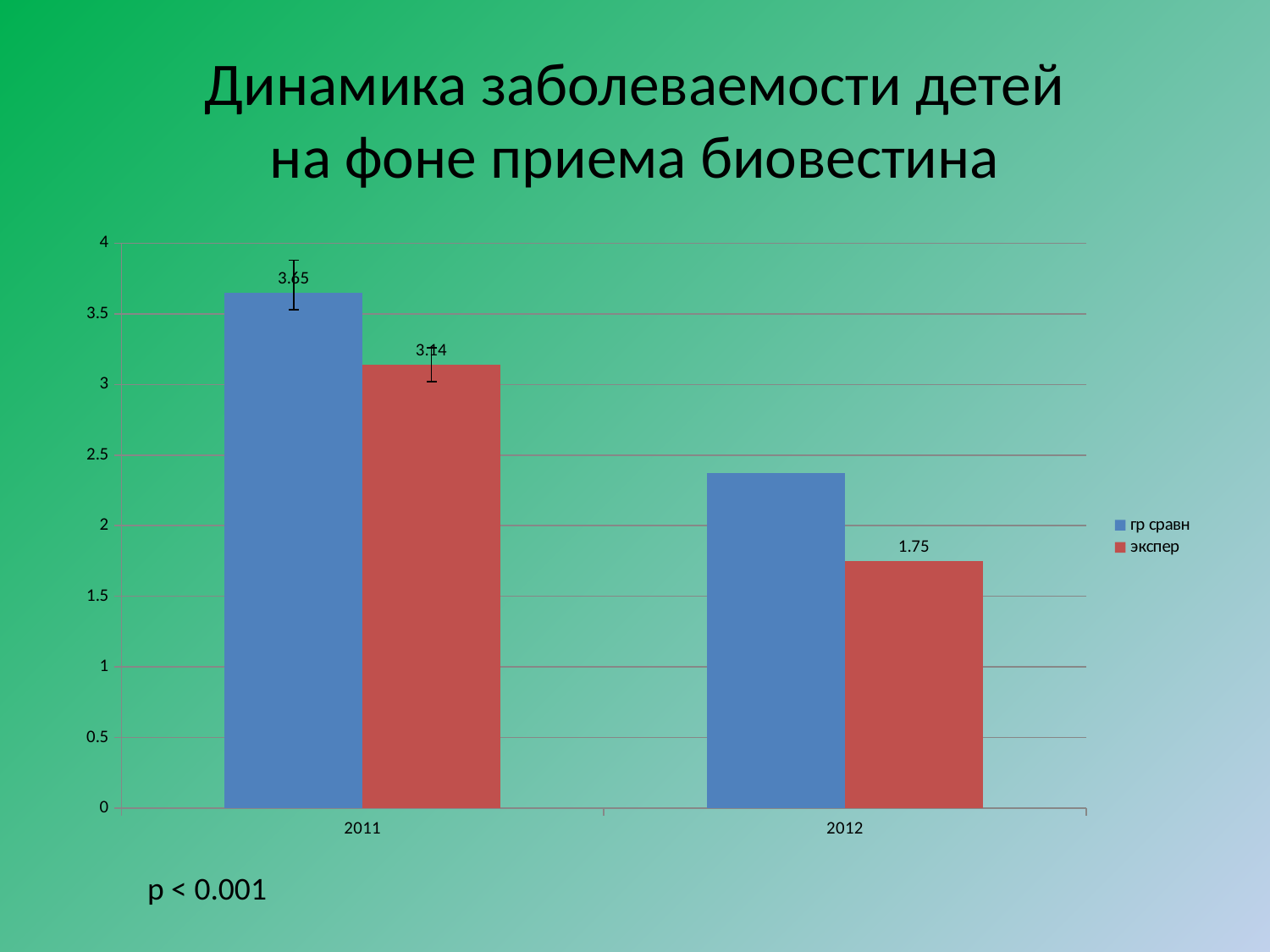
Is the value for гр сравн in 2012 greater or less than 2.5? less What kind of chart is shown on the slide? bar chart What is the value for гр сравн in 2011? 3.65 What is the value for экспер in 2012? 1.75 Which bar is the lowest in the chart? экспер in 2012 What is the difference between гр сравн and экспер in 2011? 0.51 How many series does the legend list? 2 How many years are shown on the x axis? 2 What is the value for экспер in 2011? 3.14 By how much did the экспер value fall from 2011 to 2012? 1.39 In 2012, which series has the larger value, гр сравн or экспер? гр сравн Is the value for гр сравн in 2012 greater or less than 2? greater